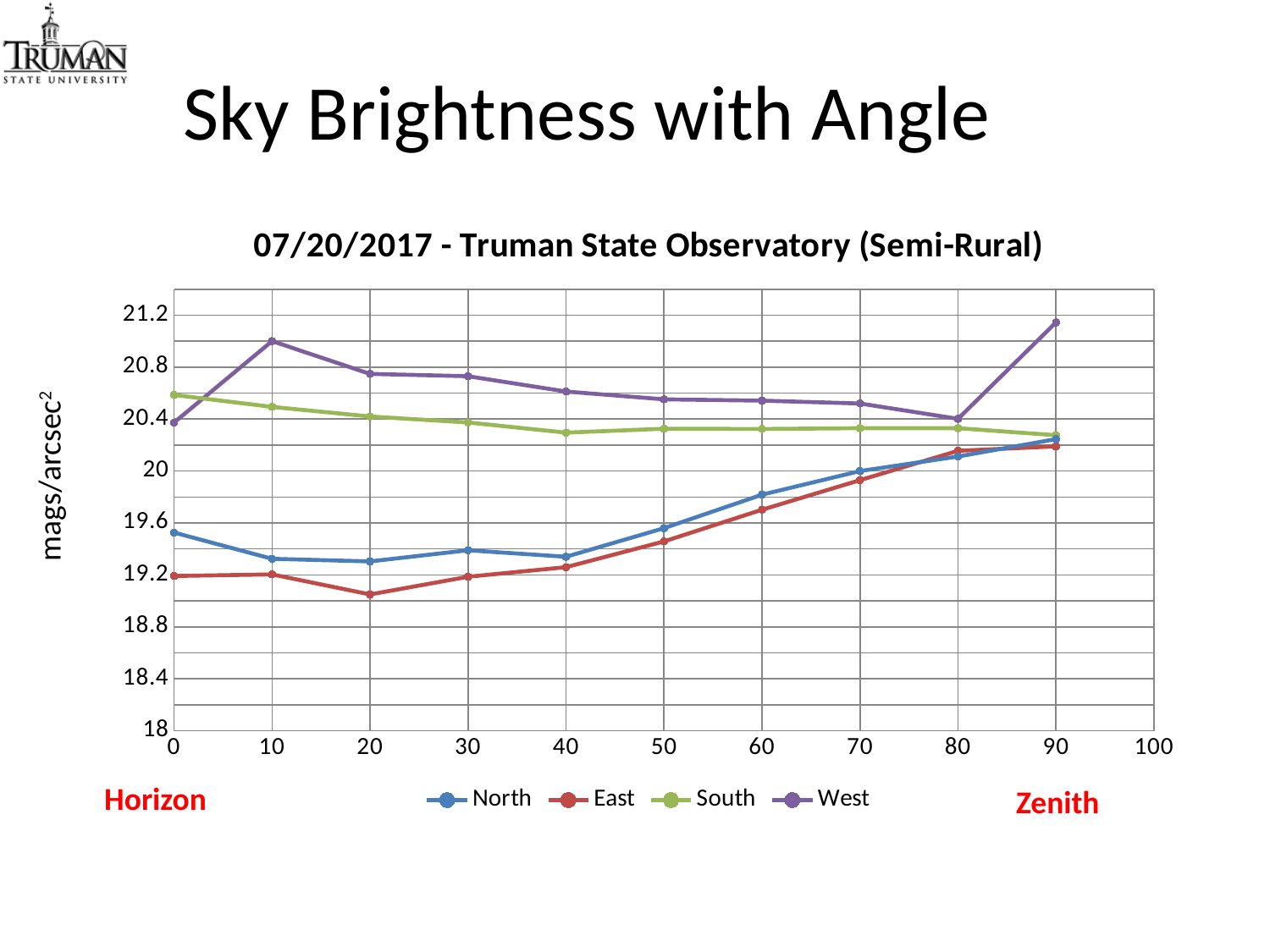
Does the East series rise or fall from an angle of 20 to an angle of 90? rise At which angle does the West series reach its highest value? 90 Which series has the lowest value at an angle of 20? East How many data points are plotted for the North series? 10 Is the value for South at an angle of 0 greater or less than 20.4? greater At an angle of 0, which series has the larger value, North or East? North How many series does the legend list? 4 Is the value for East at an angle of 20 greater or less than 19.2? less What is the title of the chart? 07/20/2017 - Truman State Observatory (Semi-Rural) Is the value for West at an angle of 10 greater or less than 20.8? greater Which series has the highest value at an angle of 90? West What kind of chart is shown on the slide? line chart